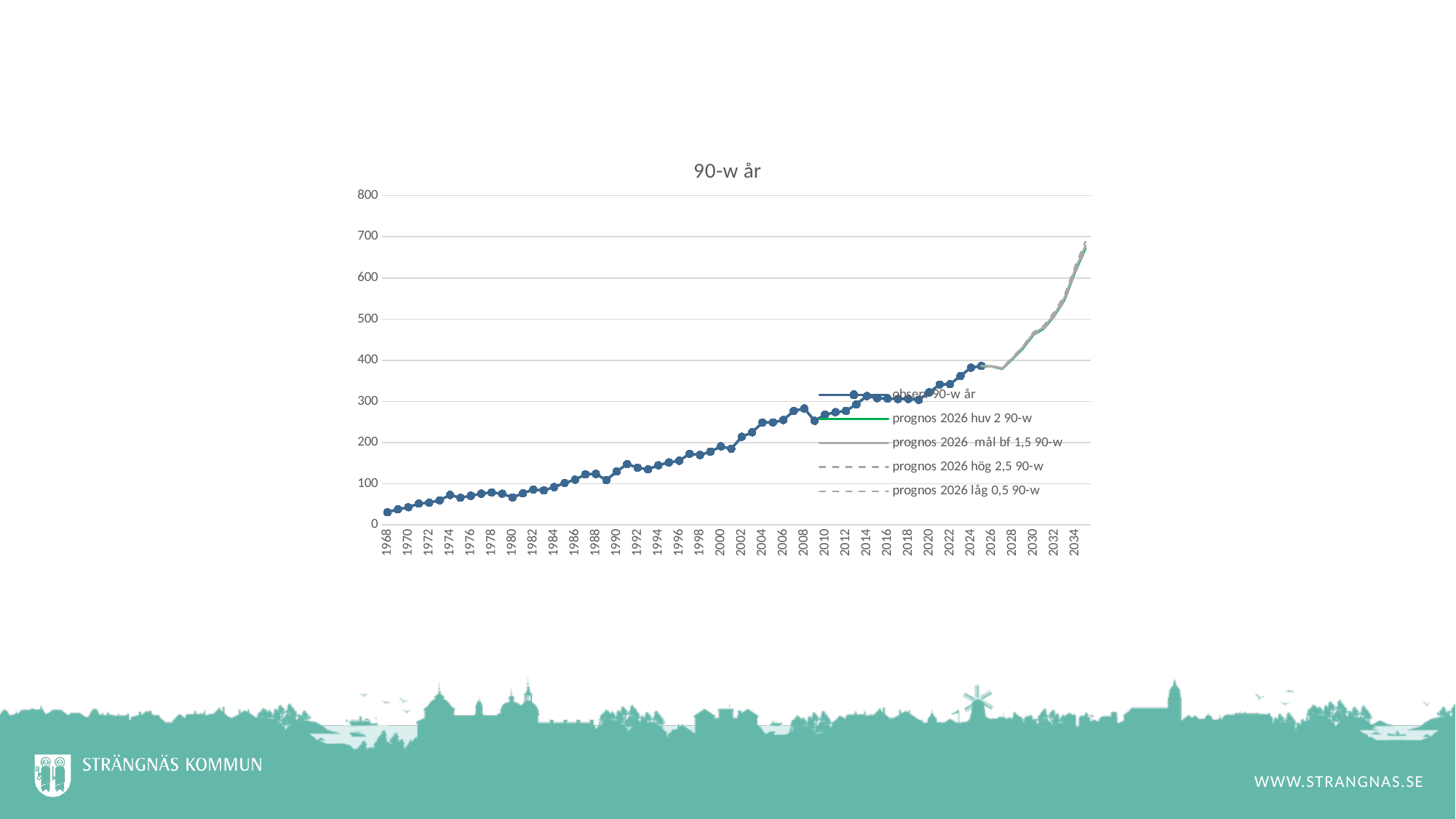
Is the value for 1968 greater or less than 100? less Is the value for 1990 greater or less than 200? less Do the values generally rise or fall from 1968 to 2034? rise Is the value for 2010 greater or less than 300? less What is the title of the chart? 90-w år What kind of chart is shown on the slide? line chart Which year shown on the x axis has the highest value? 2034 How many series does the legend list? 5 Which legend entry is drawn with a green line? prognos 2026 huv 2 90-w